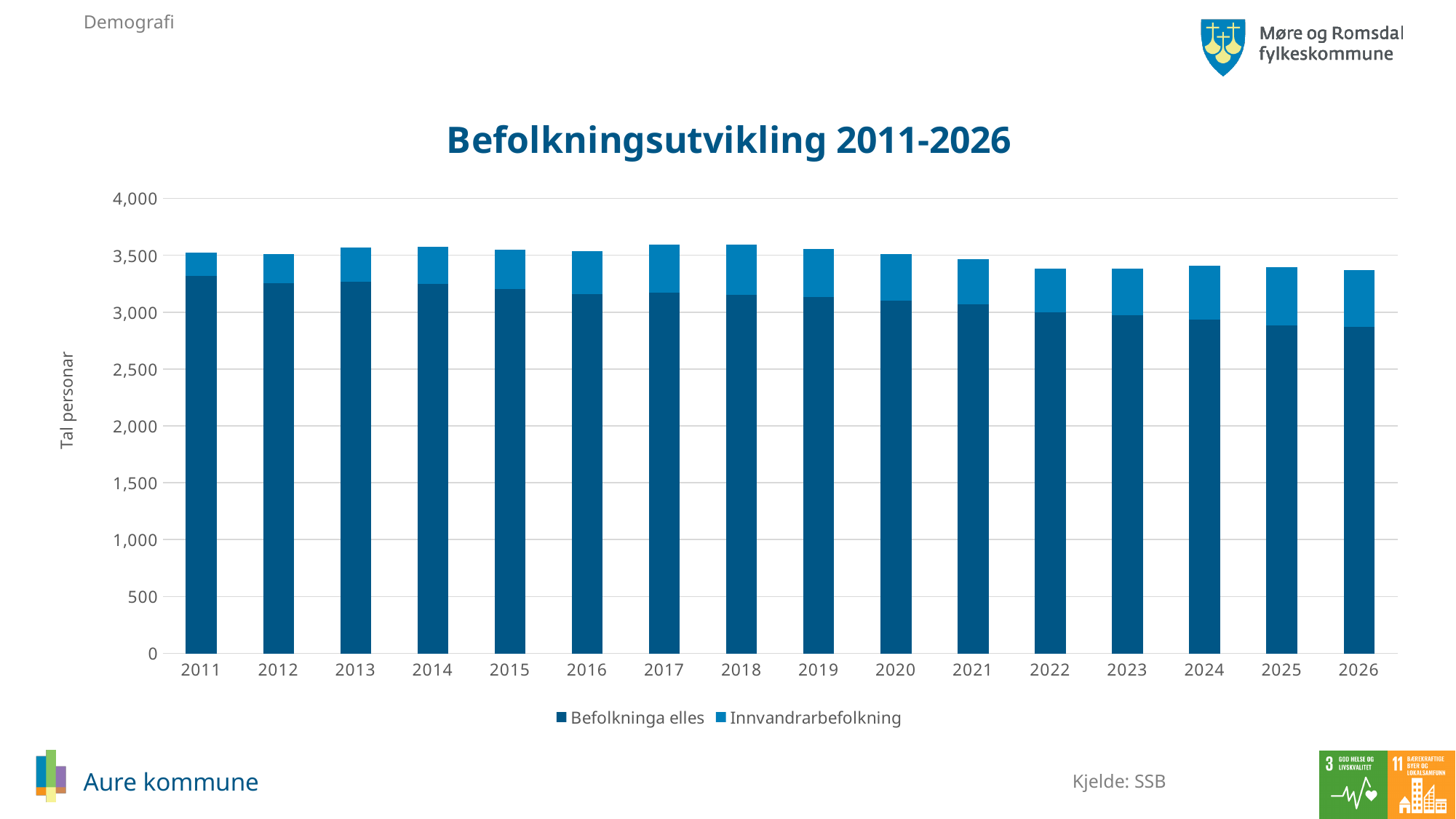
Is the value for Befolkninga elles in 2026 greater or less than 3,000? less What is the title of the chart? Befolkningsutvikling 2011-2026 Which is larger: Befolkninga elles in 2011 or Befolkninga elles in 2026? 2011 Which is larger: Innvandrarbefolkning in 2011 or Innvandrarbefolkning in 2026? 2026 Is the total height of the 2026 bar greater or less than 3,500? less Does the Befolkninga elles series rise or fall from 2011 to 2026? fall Is the value for Befolkninga elles in 2011 greater or less than 3,000? greater How many years are shown on the x axis? 16 What is the label on the y axis? Tal personar How many series does the legend list? 2 What kind of chart is shown on the slide? Stacked bar chart